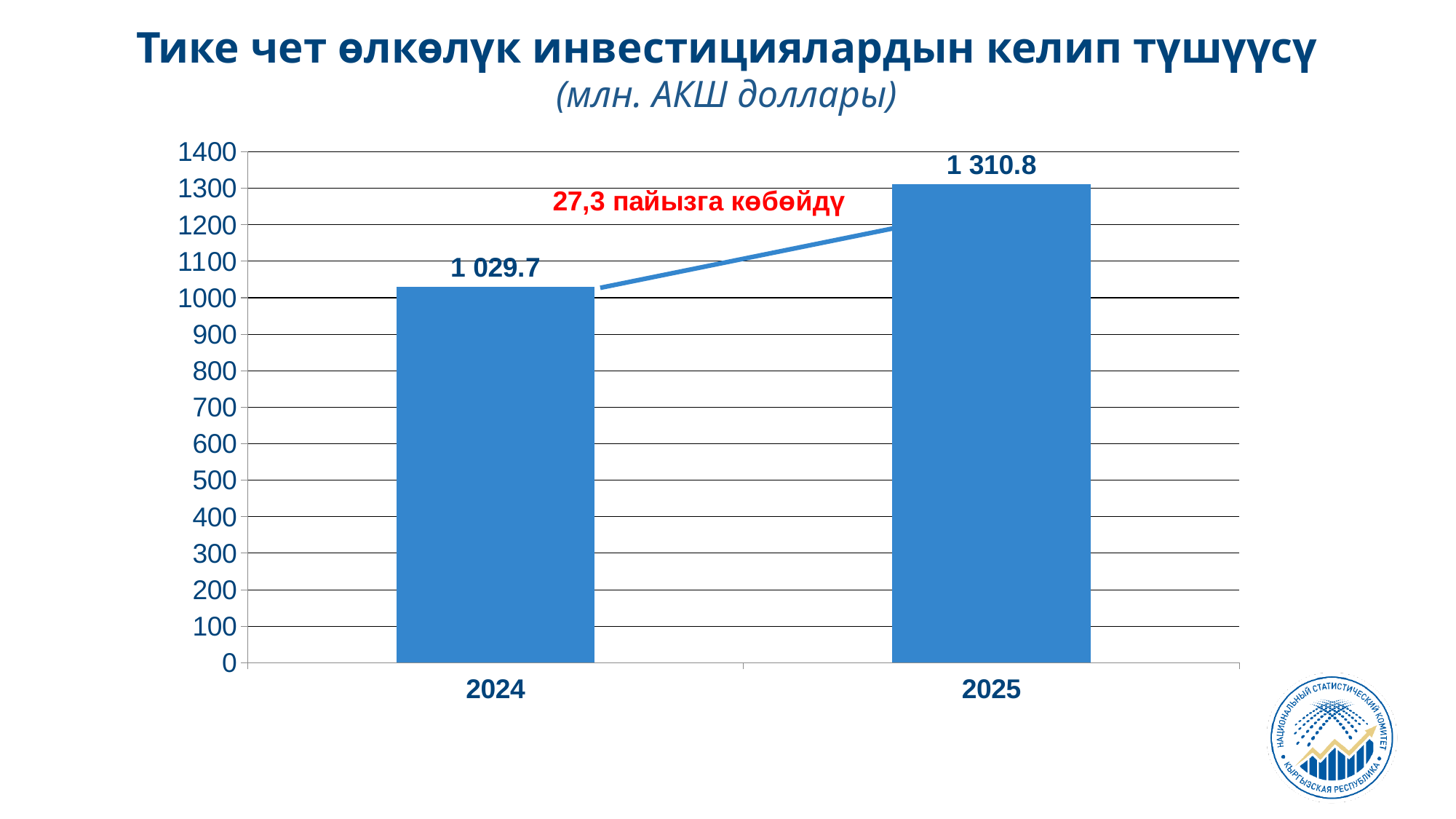
What is the value for 2024? 1 029.7 Is the value for 2024 greater or less than 1100? less What kind of chart is shown on the slide? Bar chart How many years are shown on the x axis? 2 Is the value for 2025 greater or less than 1200? greater Which year has the higher value? 2025 Do the values rise or fall from 2024 to 2025? Rise What is the difference between the 2025 and 2024 values? 281.1 Is the value for 2025 larger than the value for 2024? Yes What percentage increase is annotated in red on the chart? 27,3 What is the value for 2025? 1 310.8 Which year has the lower value? 2024